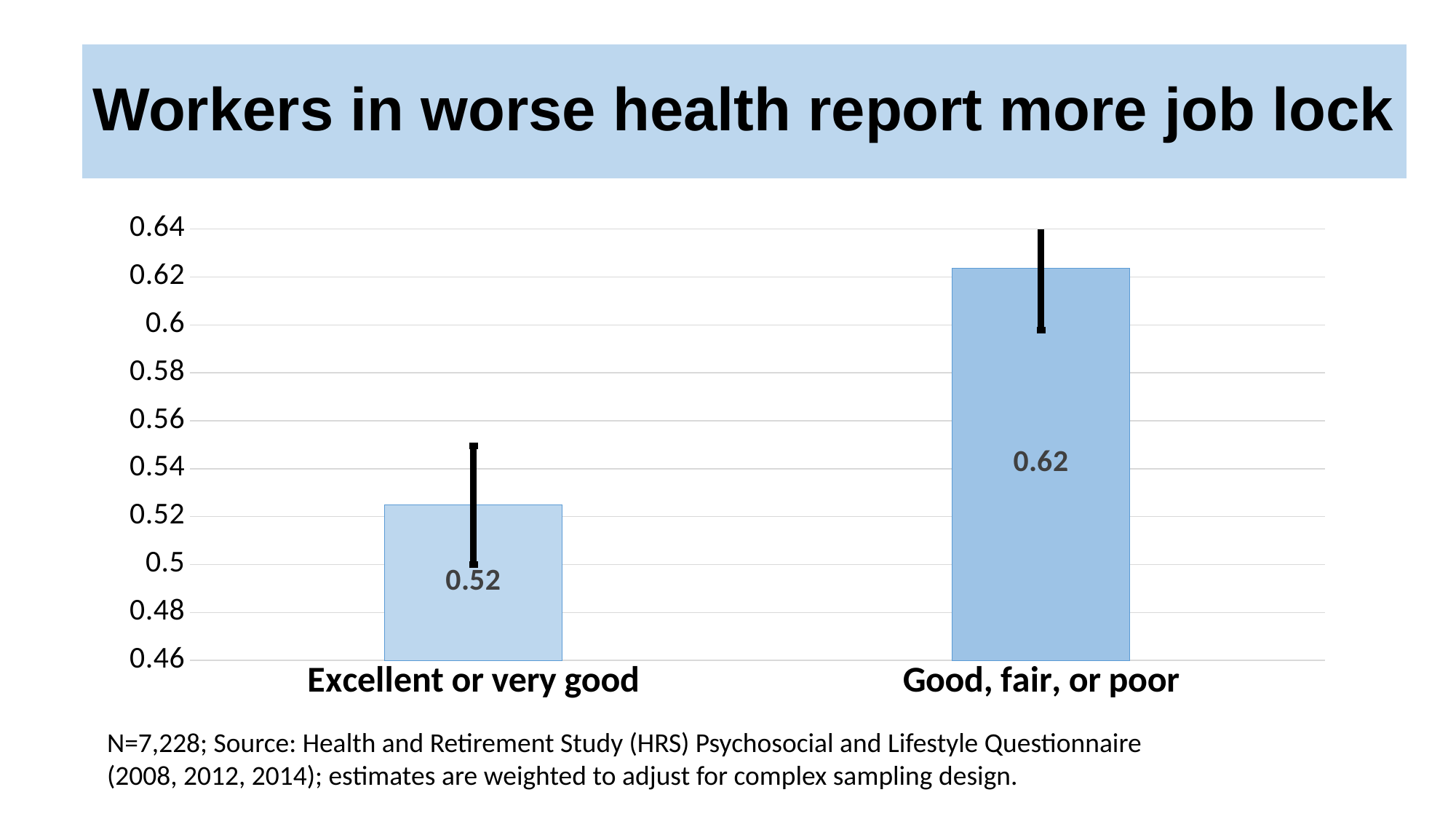
Is the value for "Excellent or very good" greater or less than 0.56? less Which health category has the highest value? Good, fair, or poor Is the value for "Good, fair, or poor" greater or less than 0.6? greater Which is larger: the value for "Excellent or very good" or the value for "Good, fair, or poor"? Good, fair, or poor What is the value for the "Good, fair, or poor" health category? 0.62 What is the sample size (N) stated in the note below the chart? 7,228 Which health category has the lowest value? Excellent or very good What is the title of the slide? Workers in worse health report more job lock How many health categories are shown in the chart? 2 What is the value for the "Excellent or very good" health category? 0.52 What kind of chart is shown on the slide? bar chart What is the difference between the values for "Good, fair, or poor" and "Excellent or very good"? 0.10